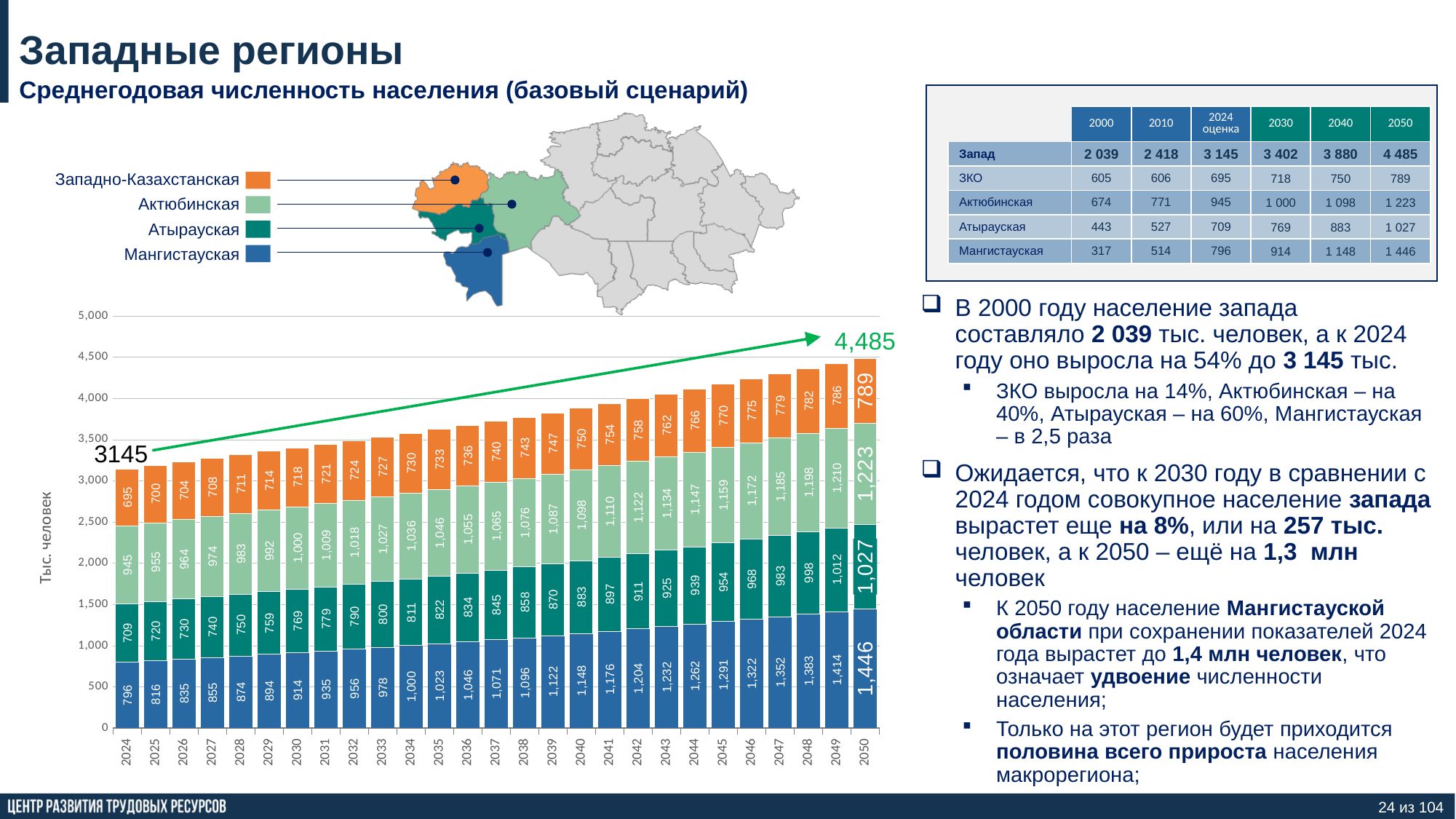
How many years (bars) are plotted along the x axis of the chart? 27 What is the value for Мангистауская in 2024? 796 What is the total of the stacked bar for 2024? 3145 Which series has the smallest value in 2024? Западно-Казахстанская What is the total of the stacked bar for 2050? 4,485 How many series does the chart legend list? 4 What kind of chart is shown on the slide? Stacked bar chart What is the value for Актюбинская in 2040? 1,098 By how much does the value for Мангистауская in 2050 exceed its value in 2024? 650 What is the value for Западно-Казахстанская in 2050? 789 What is the value for Атырауская in 2030? 769 In 2050, which is larger: Мангистауская or Актюбинская? Мангистауская